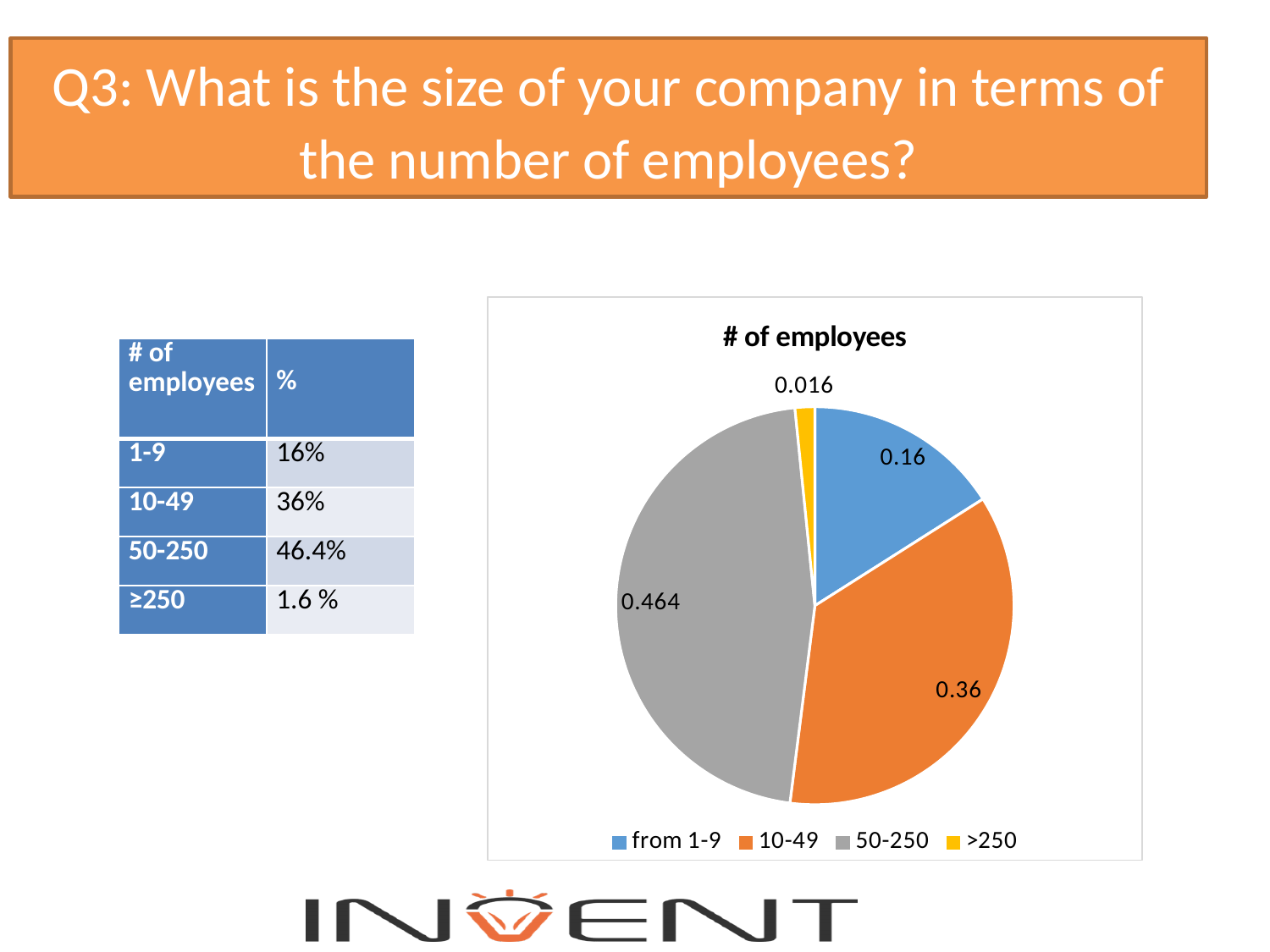
What colour is the 50-250 slice in the pie chart? grey What type of chart is shown on the slide? pie chart What value is shown for the 10-49 slice of the pie chart? 0.36 What is the difference between the values for the 50-250 slice and the 10-49 slice? 0.104 What value is shown for the 50-250 slice of the pie chart? 0.464 Which category has the smallest slice of the pie chart? >250 How many slices does the pie chart have? 4 What is the title of the chart? # of employees Which slice is larger, 10-49 or 'from 1-9'? 10-49 What value is shown for the >250 slice of the pie chart? 0.016 What value is shown for the 'from 1-9' slice of the pie chart? 0.16 Which category has the largest slice of the pie chart? 50-250